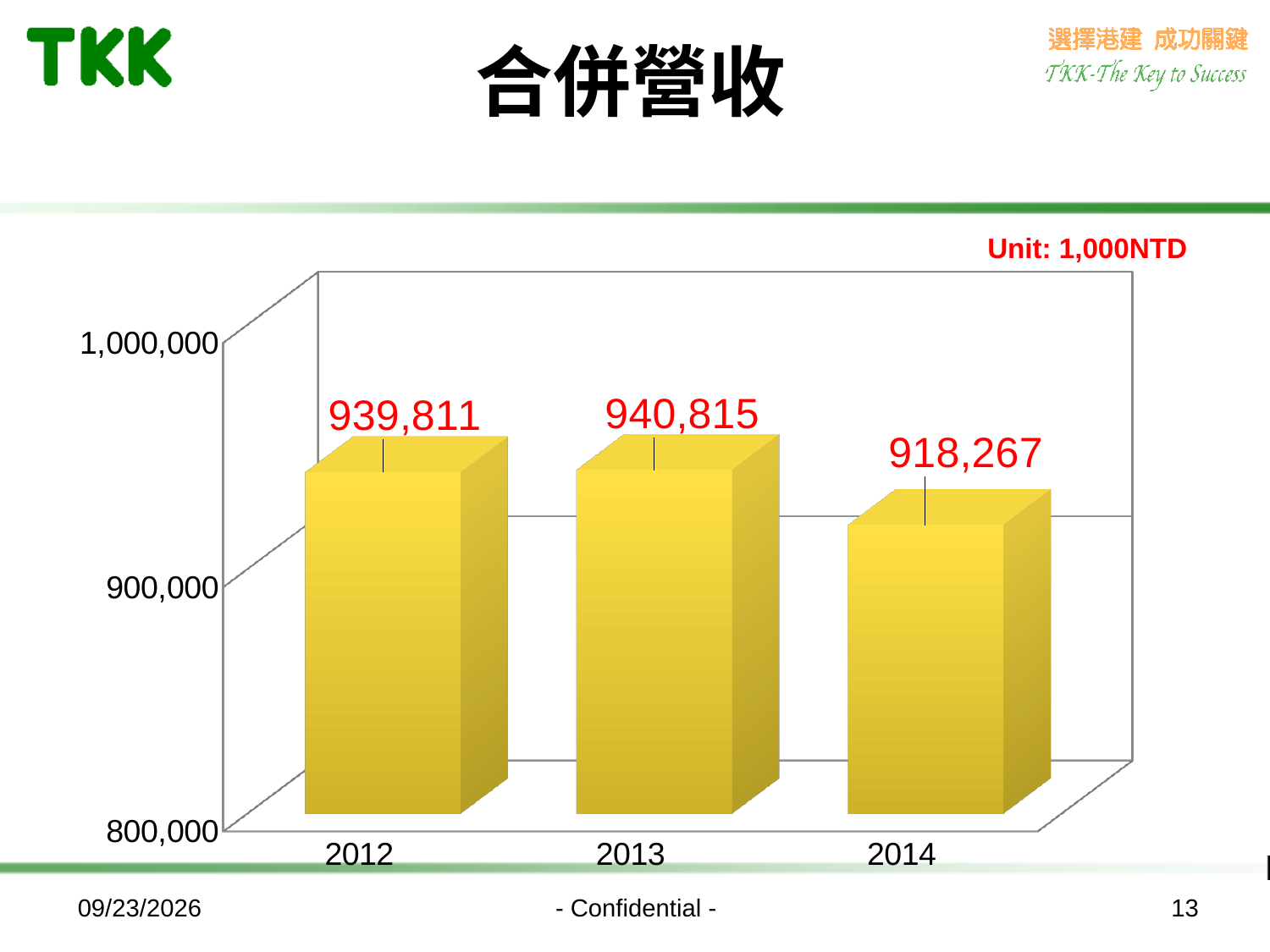
What is the value for 2013? 940,815 Which year has the lowest value? 2014 What is the value for 2014? 918,267 Which is larger, the value for 2012 or the value for 2014? 2012 Which year has the highest value? 2013 What is the difference between the values for 2013 and 2014? 22,548 What unit is stated for the chart values? 1,000NTD What is the difference between the values for 2012 and 2014? 21,544 What is the value for 2012? 939,811 What kind of chart is shown on the slide? bar chart Is the value for 2014 greater or less than 900,000? greater How many years are shown on the chart? 3